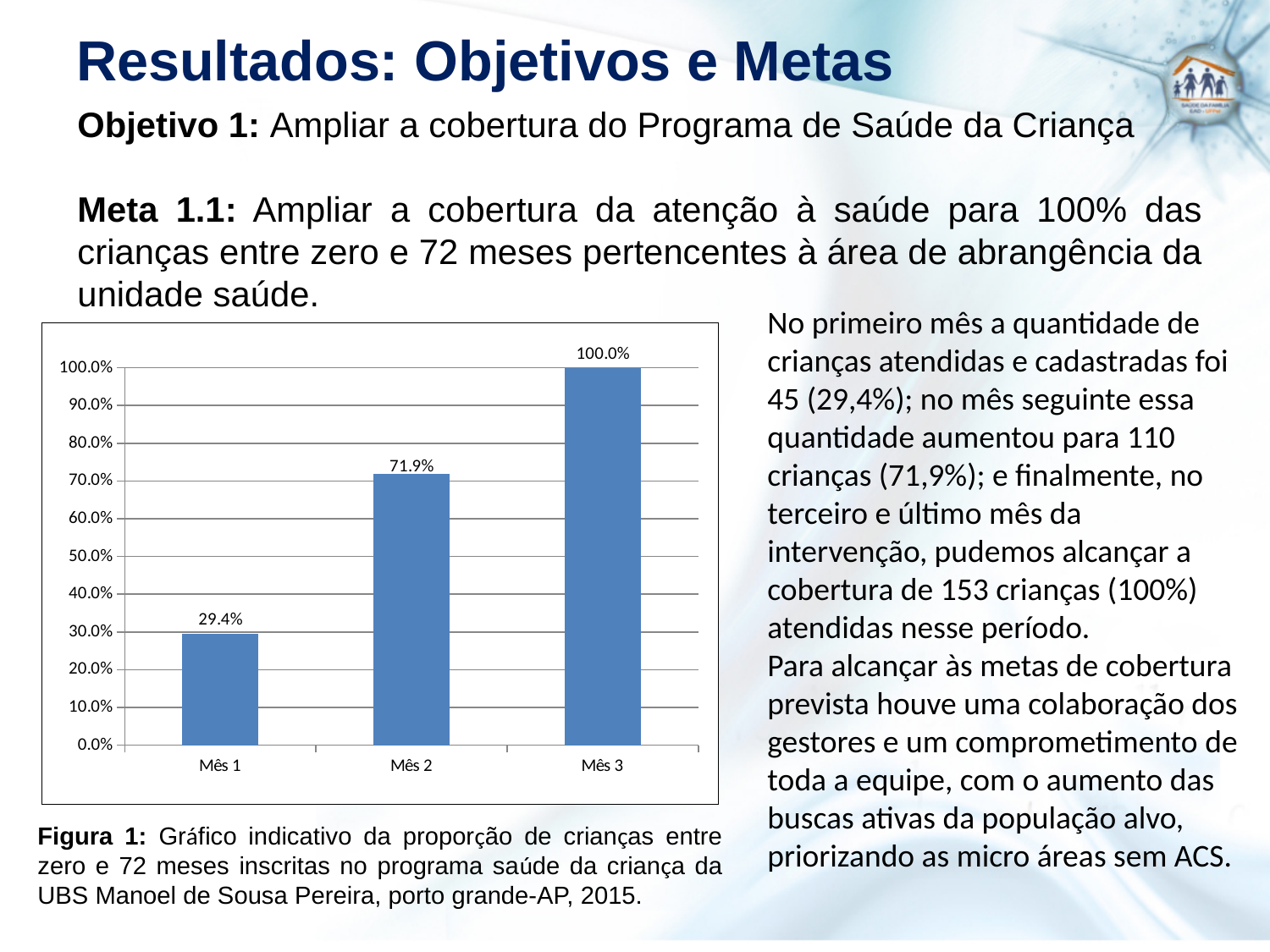
What is the value for Mês 3? 100.0% Which month has the lowest value? Mês 1 What is the difference between the values for Mês 3 and Mês 2? 28.1% Which month has the highest value? Mês 3 Is the value for Mês 2 greater or less than 70.0%? greater How many categories are shown on the x axis? 3 Which is larger, the value for Mês 1 or the value for Mês 2? Mês 2 What kind of chart is shown on the slide? bar chart What is the value for Mês 1? 29.4% What is the difference between the values for Mês 2 and Mês 1? 42.5% Do the values rise or fall from Mês 1 to Mês 3? rise What is the value for Mês 2? 71.9%